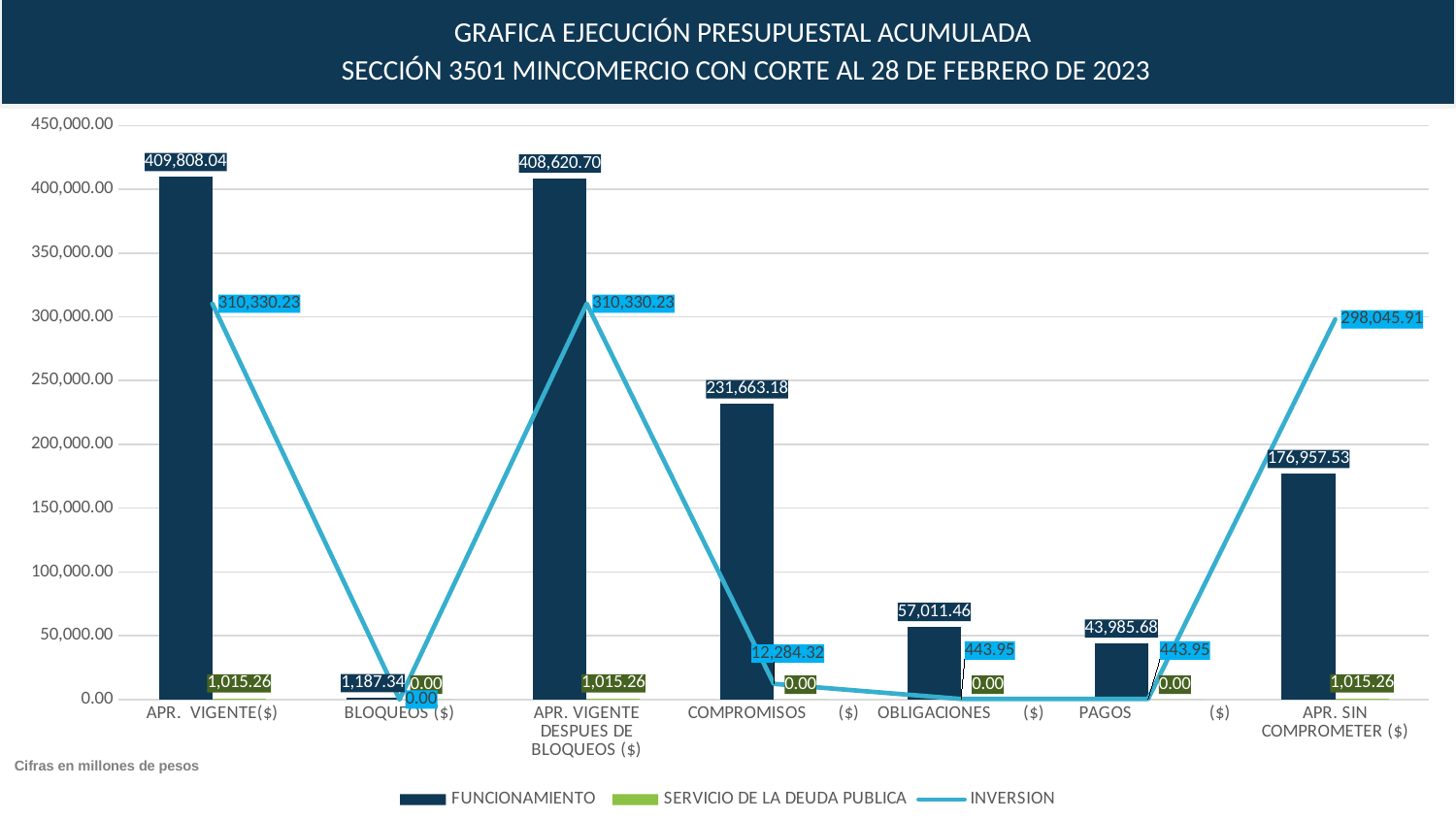
What is the FUNCIONAMIENTO value for APR. VIGENTE($)? 409,808.04 How many series does the legend list? 3 How many categories are shown on the x axis? 7 What is the FUNCIONAMIENTO value for COMPROMISOS ($)? 231,663.18 Which category has the highest FUNCIONAMIENTO value? APR. VIGENTE($) What is the SERVICIO DE LA DEUDA PUBLICA value for APR. VIGENTE($)? 1,015.26 What is the INVERSION value for APR. SIN COMPROMETER ($)? 298,045.91 Which series is plotted as a line rather than bars? INVERSION What is the difference between the FUNCIONAMIENTO values for APR. VIGENTE($) and APR. VIGENTE DESPUES DE BLOQUEOS ($)? 1,187.34 What kind of chart is shown on the slide? Combination bar and line chart Which category has the lowest FUNCIONAMIENTO value? BLOQUEOS ($) Which has the larger FUNCIONAMIENTO value, OBLIGACIONES ($) or PAGOS ($)? OBLIGACIONES ($)